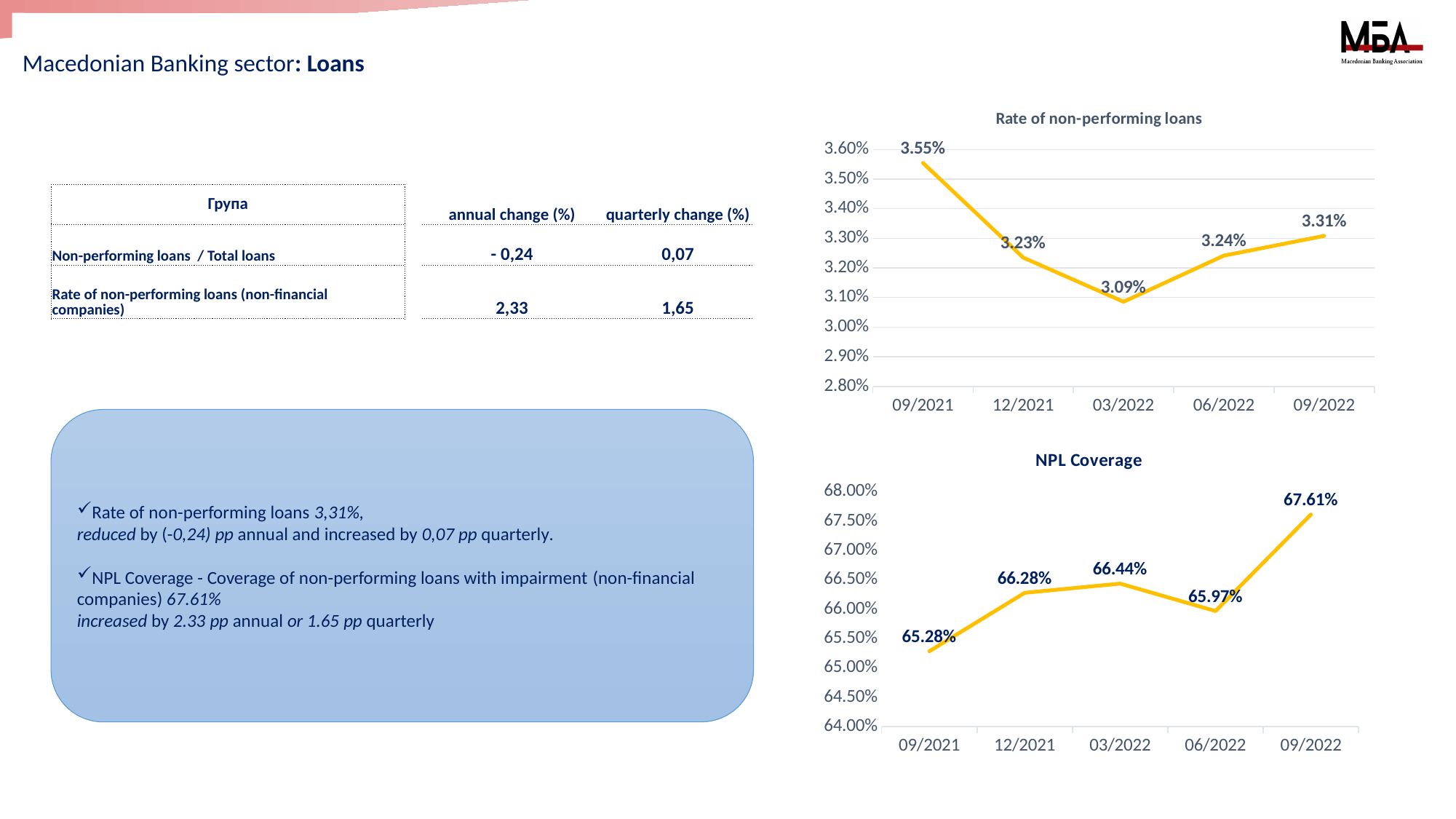
In the 'Rate of non-performing loans' chart, which period has the lowest value? 03/2022 In the 'Rate of non-performing loans' chart, which period has the highest value? 09/2021 In the 'Rate of non-performing loans' chart, is the value for 12/2021 greater or less than 3.30%? less In the 'NPL Coverage' chart, what is the value for 06/2022? 65.97% In the 'NPL Coverage' chart, what is the value for 09/2022? 67.61% What type of chart is the 'Rate of non-performing loans' chart? Line chart In the 'NPL Coverage' chart, what is the difference between the values for 09/2022 and 09/2021? 2.33% In the 'NPL Coverage' chart, is the value for 12/2021 or 03/2022 larger? 03/2022 In the 'Rate of non-performing loans' chart, what is the difference between the values for 09/2021 and 03/2022? 0.46% In the 'Rate of non-performing loans' chart, how many data points are plotted? 5 In the 'Rate of non-performing loans' chart, what is the value for 09/2021? 3.55% In the 'NPL Coverage' chart, which period has the lowest value? 09/2021